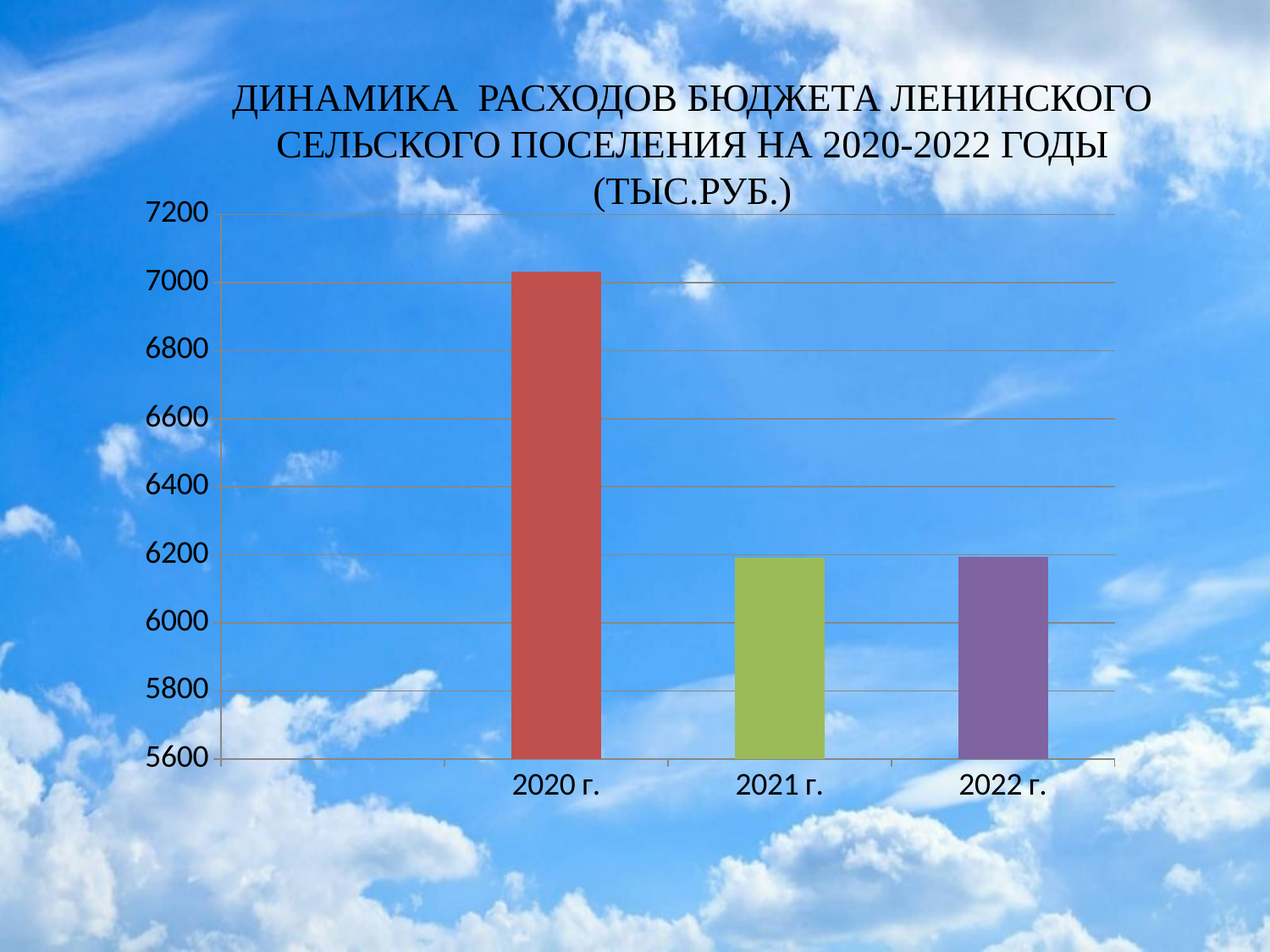
What kind of chart is shown on the slide? bar chart What colour is the bar for 2020 г.? red Is the value for 2021 г. greater or less than 6000? greater Which year has the highest budget expenditure on the chart? 2020 г. Is the value for 2022 г. greater or less than 6000? greater Which is larger, the value for 2020 г. or the value for 2022 г.? 2020 г. Is the value for 2022 г. greater or less than 6400? less How many years (categories) are plotted on the chart? 3 Do the values rise or fall from 2020 г. to 2021 г.? fall In what units are the values on the chart expressed, according to the title? тыс.руб.